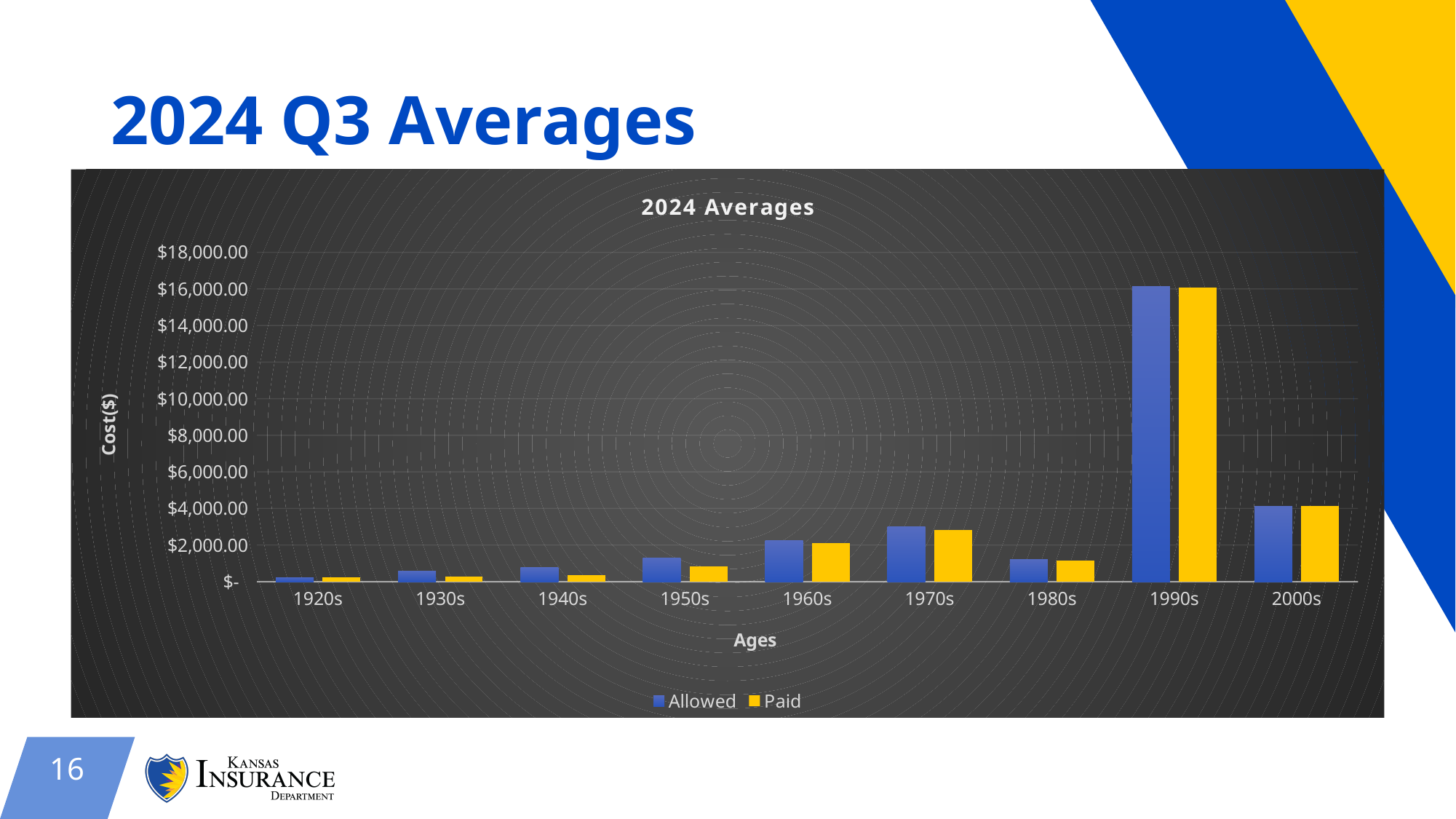
Is the Allowed value for the 2000s greater or less than $2,000.00? greater Is the Allowed value for the 1950s greater or less than $2,000.00? less How many series does the legend list? 2 Which age category has the lowest Allowed value? 1920s Which age category has the highest Paid value? 1990s Is the Allowed value for the 1990s greater or less than $14,000.00? greater How many age categories are shown on the x axis? 9 What is the label on the vertical axis of the chart? Cost($) What kind of chart is shown on the slide? bar chart Which is larger, the Allowed value for the 1970s or the Allowed value for the 1980s? 1970s Which is larger, the Paid value for the 2000s or the Paid value for the 1970s? 2000s Which age category has the highest Allowed value? 1990s